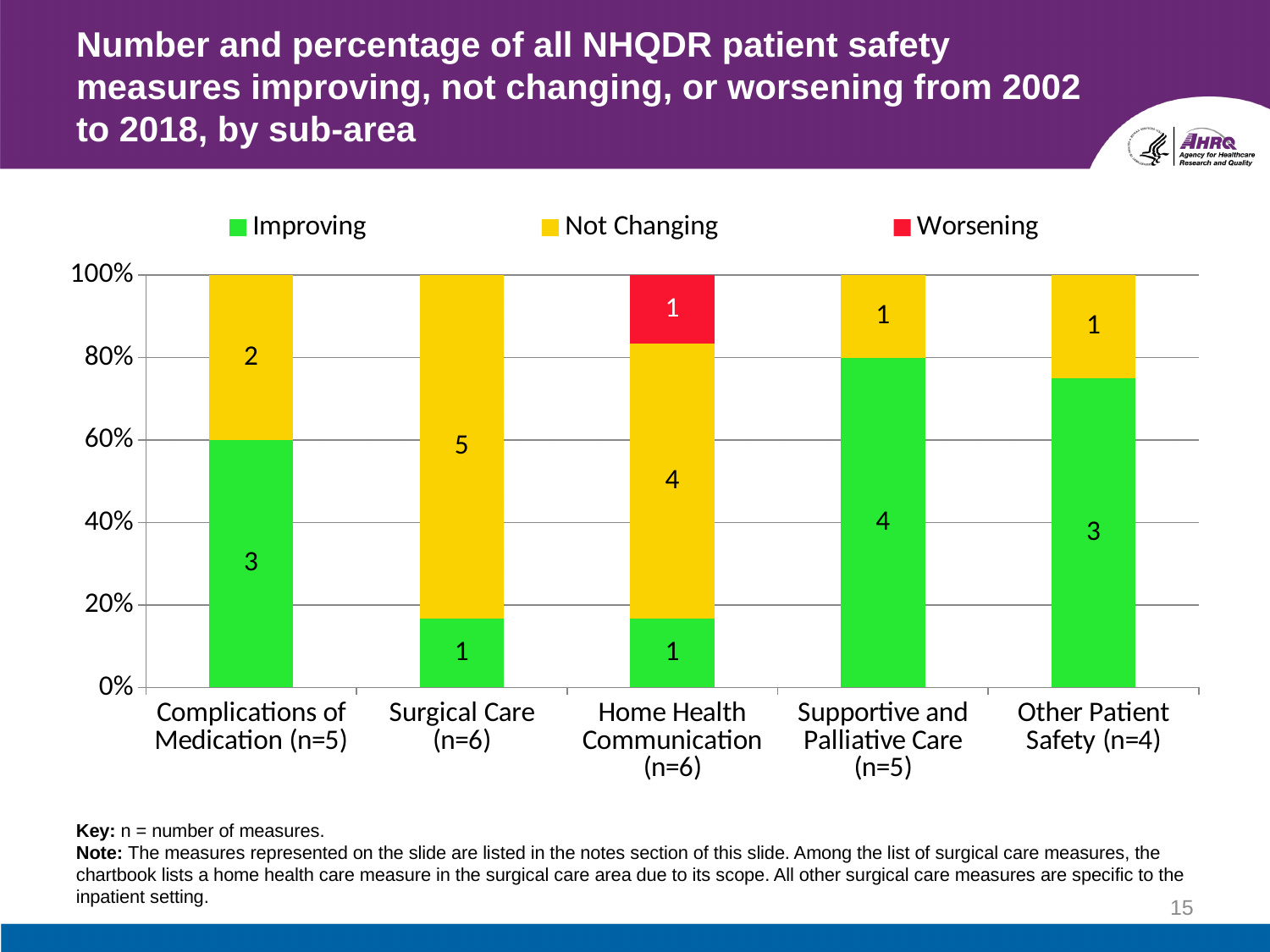
What kind of chart is shown on the slide? Stacked bar chart Is the Improving share of the bar for Surgical Care (n=6) greater or less than 20%? less How many measures are labeled as Improving for Supportive and Palliative Care (n=5)? 4 Which sub-area has the highest number of Not Changing measures? Surgical Care (n=6) What is the difference between the Not Changing and Improving counts for Surgical Care (n=6)? 4 What is the total number of measures shown in the Home Health Communication (n=6) bar? 6 How many sub-areas are shown on the x axis? 5 How many measures are labeled as Not Changing for Surgical Care (n=6)? 5 How many series does the legend list? 3 Which is larger for Complications of Medication (n=5): the Improving count or the Not Changing count? Improving How many measures are labeled as Worsening for Home Health Communication (n=6)? 1 Which sub-area has the highest number of Improving measures? Supportive and Palliative Care (n=5)